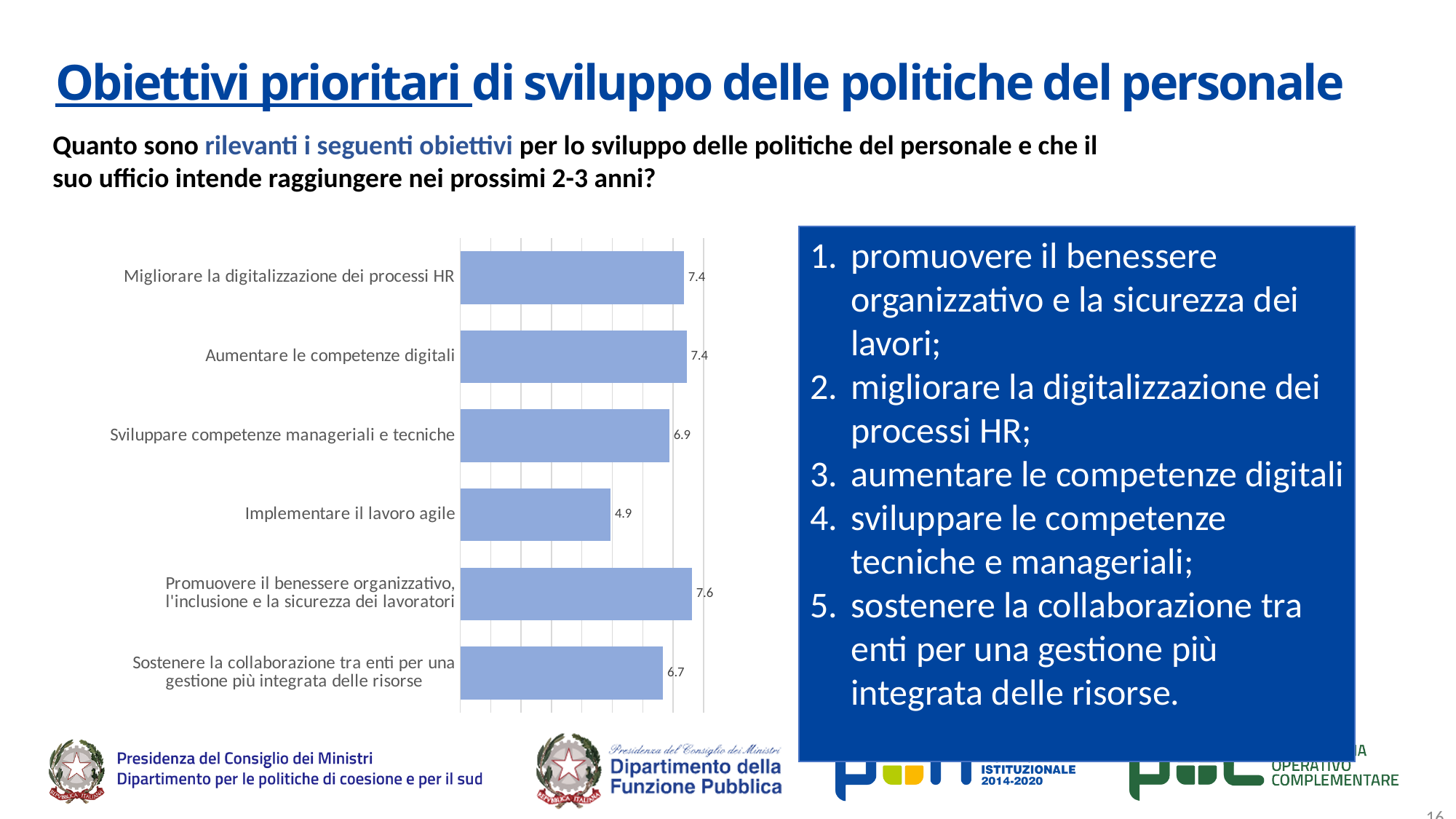
What is the difference between the value for "Promuovere il benessere organizzativo, l'inclusione e la sicurezza dei lavoratori" and the value for "Implementare il lavoro agile"? 2.7 What is the value for "Sviluppare competenze manageriali e tecniche"? 6.9 What is the value for "Aumentare le competenze digitali"? 7.4 How many categories are shown in the chart? 6 Which category has the highest value? Promuovere il benessere organizzativo, l'inclusione e la sicurezza dei lavoratori What kind of chart is shown on the slide? Bar chart What is the value for "Implementare il lavoro agile"? 4.9 What colour are the bars in the chart? Light blue Which is larger: the value for "Sviluppare competenze manageriali e tecniche" or the value for "Implementare il lavoro agile"? Sviluppare competenze manageriali e tecniche Which category has the lowest value? Implementare il lavoro agile What is the difference between the value for "Migliorare la digitalizzazione dei processi HR" and the value for "Sostenere la collaborazione tra enti per una gestione più integrata delle risorse"? 0.7 What is the value for "Sostenere la collaborazione tra enti per una gestione più integrata delle risorse"? 6.7